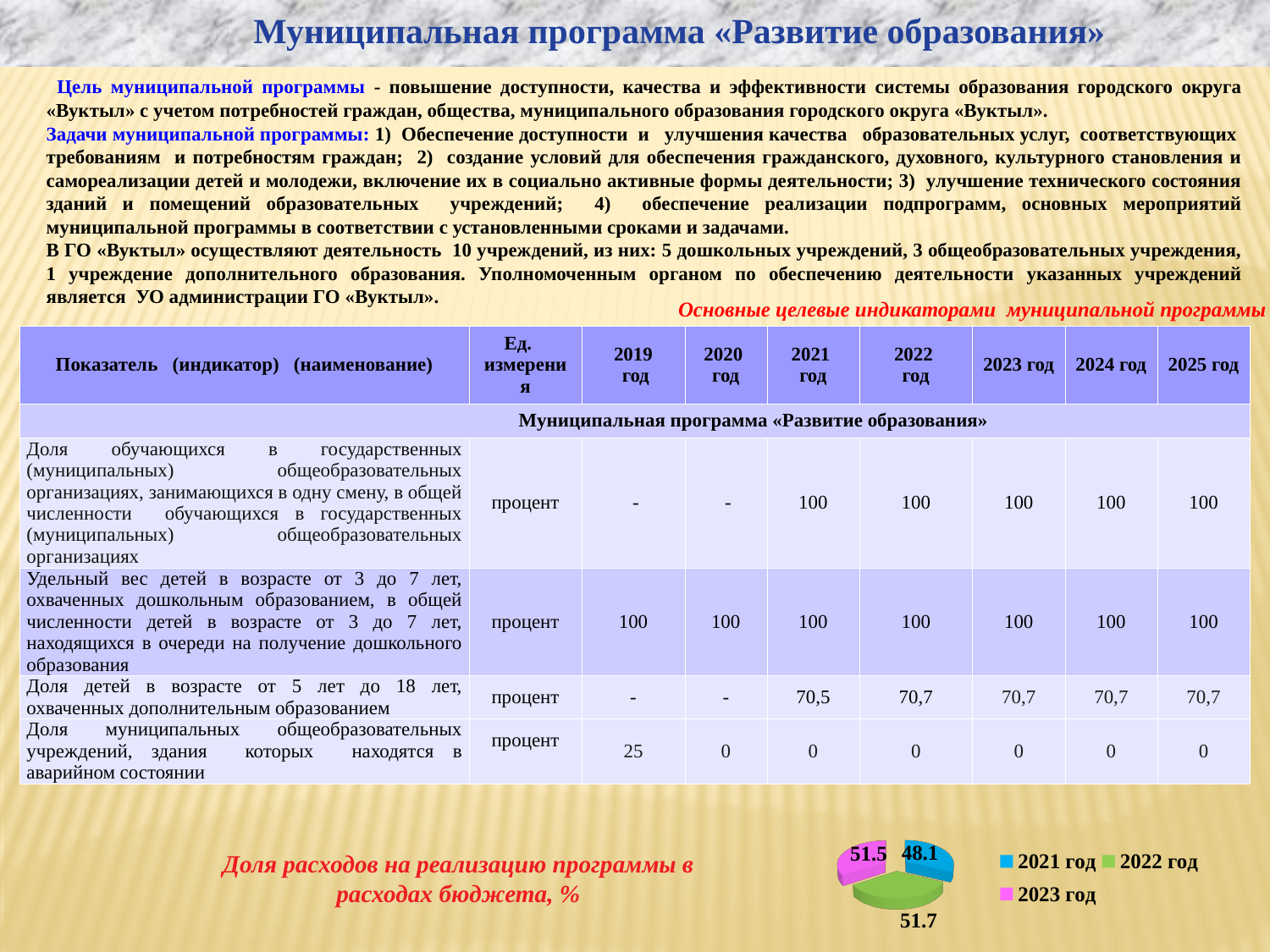
How many slices does the pie chart have? 3 What is the difference between the largest and smallest data label values on the pie chart? 3.6 What is the largest data label value shown on the pie chart? 51.7 How many entries does the legend of the pie chart list? 3 What is the smallest data label value shown on the pie chart? 48.1 What kind of chart is shown at the bottom of the slide? pie chart What is the title of the pie chart? Доля расходов на реализацию программы в расходах бюджета, % On the pie chart, which is larger: the slice labelled 51.5 or the slice labelled 48.1? 51.5 Is the slice labelled 48.1 on the pie chart greater or less than 50? less Which years are listed in the legend of the pie chart? 2021 год, 2022 год, 2023 год